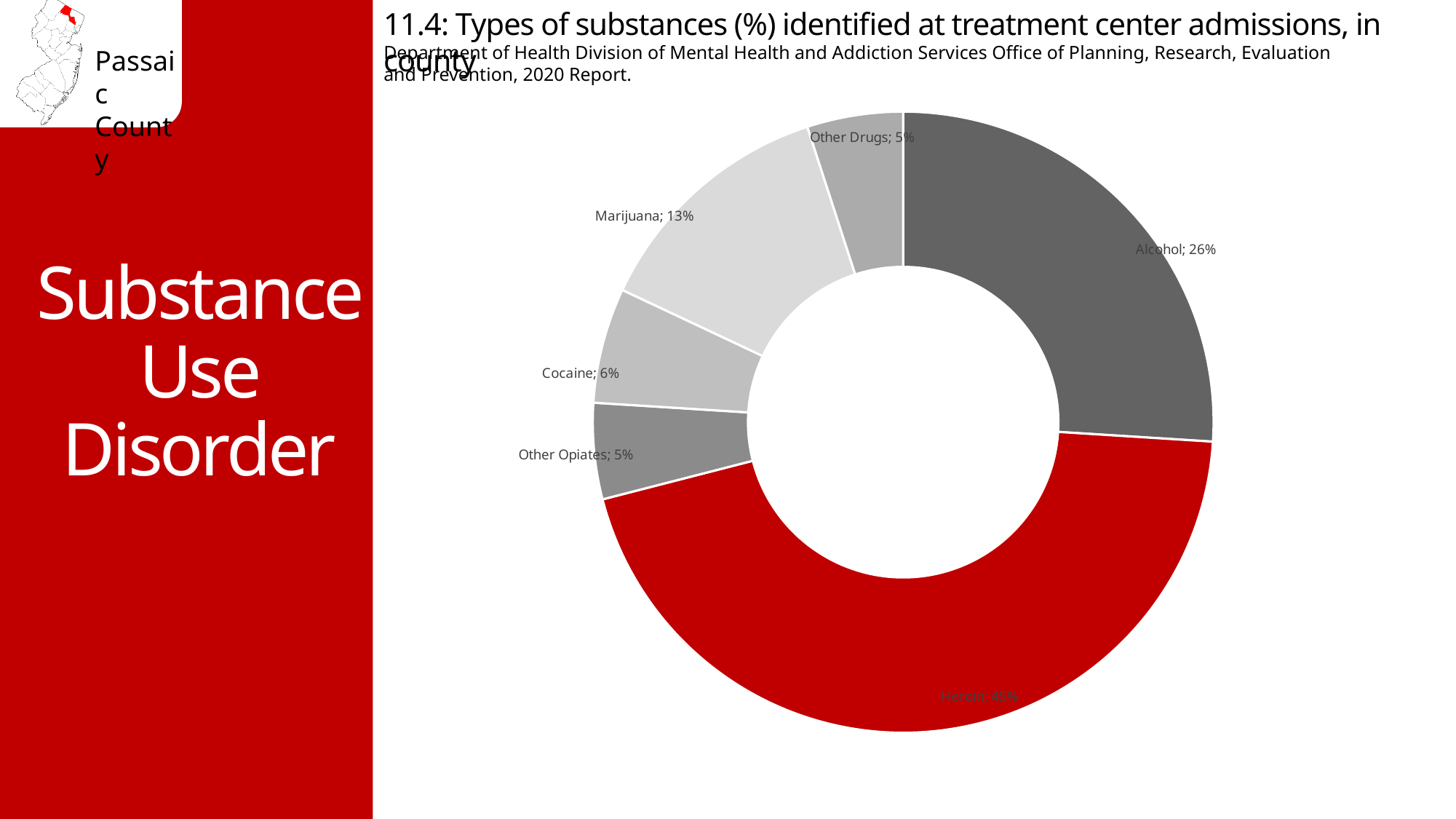
What type of chart is shown on the slide? Pie (donut) chart Which has a larger share, Cocaine or Other Opiates? Cocaine What percentage is shown for Cocaine? 6% Which substance has the largest share of the chart? Heroin What percentage is shown for Other Opiates? 5% How many substance categories are shown in the chart? 6 What percentage is shown for Heroin? 45% What percentage of treatment center admissions identified Alcohol? 26% What percentage is shown for Marijuana? 13% What percentage is shown for Other Drugs? 5% Which slice of the chart is coloured red? Heroin How many percentage points higher is Alcohol than Marijuana? 13